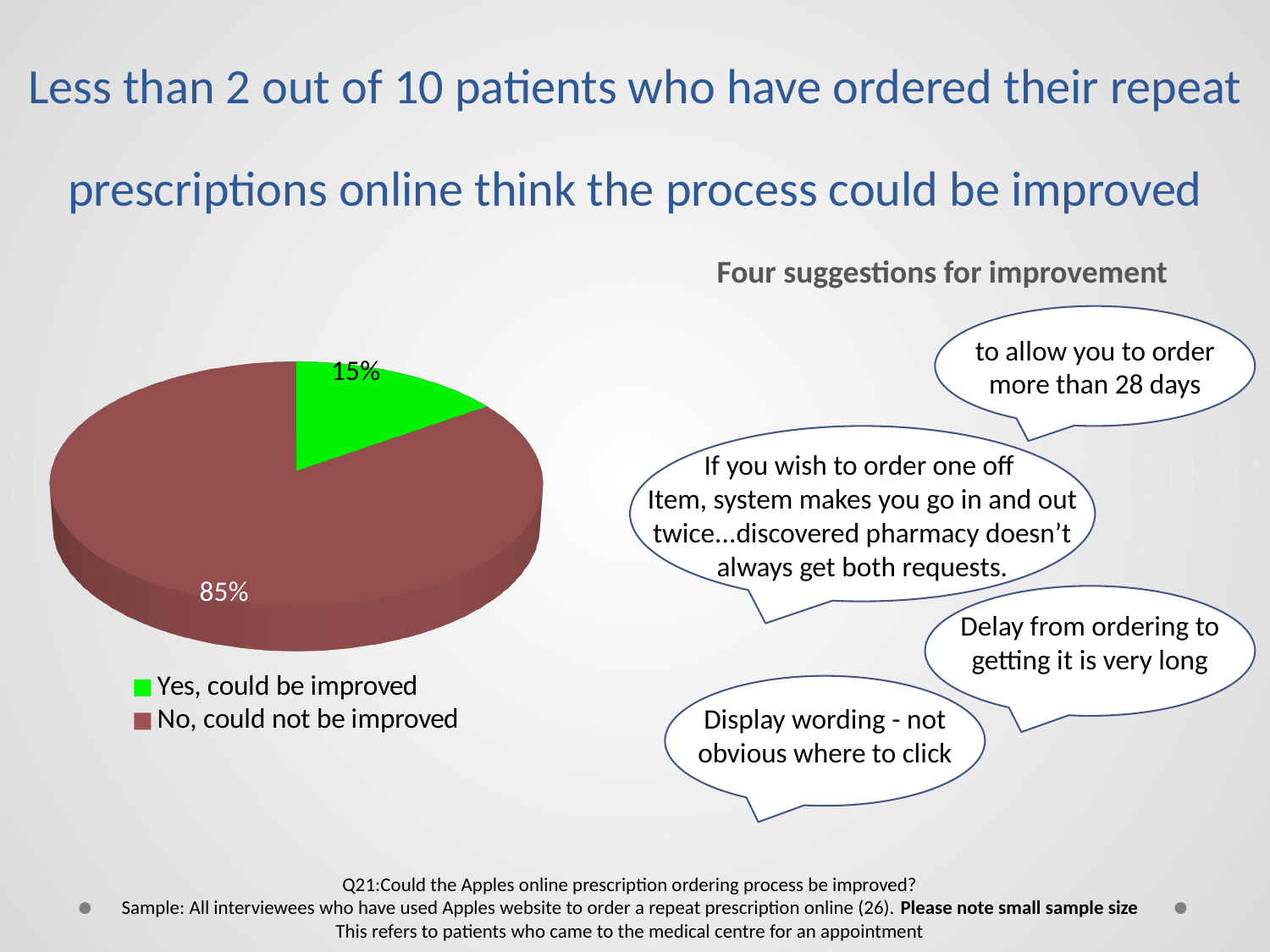
What percentage of patients said the online prescription ordering process could be improved? 15% How many slices does the pie chart have? 2 Which response has the smallest share of the pie? Yes, could be improved What is the share of the pie for 'No, could not be improved'? 85% Which response has the largest share of the pie? No, could not be improved What is the sample size noted for the chart? 26 How many entries does the legend list? 2 What kind of chart is shown on the slide? Pie chart Which is larger: the share for 'Yes, could be improved' or 'No, could not be improved'? No, could not be improved What is the difference in percentage points between the 'No, could not be improved' and 'Yes, could be improved' slices? 70 What colour is the 'Yes, could be improved' slice? Green What percentage of patients said the process could not be improved? 85%